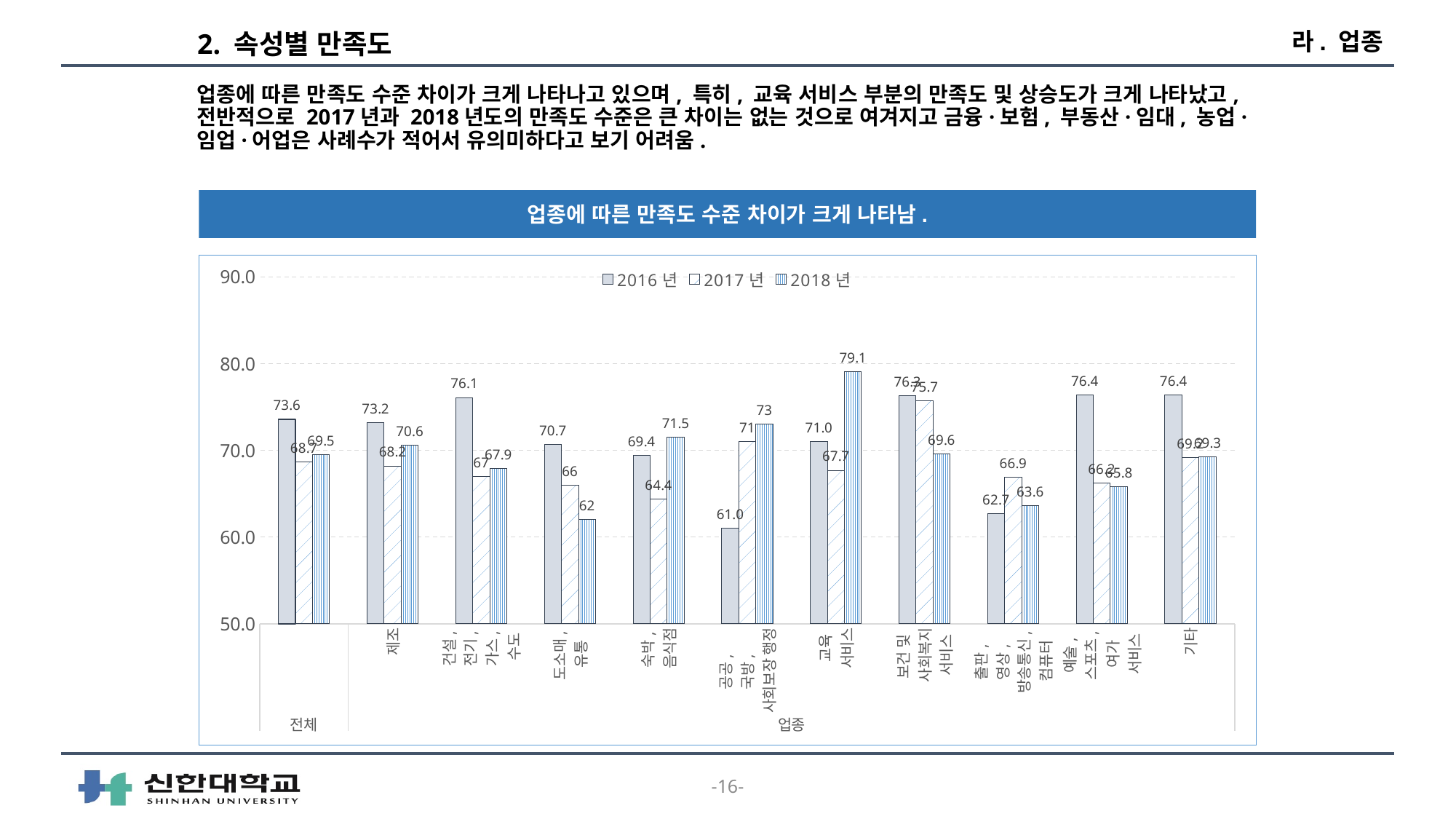
What kind of chart is shown on the slide? bar chart What is the 2017 년 value for 숙박, 음식점? 64.4 What is the difference between the 2018 년 and 2017 년 values for 교육 서비스? 11.4 What is the 2017 년 value for 보건 및 사회복지 서비스? 75.7 What is the 2018 년 value for 교육 서비스? 79.1 How many series does the legend list? 3 How many categories are shown along the x axis? 11 What are the three series listed in the legend? 2016 년, 2017 년, 2018 년 What is the 2016 년 value for 전체? 73.6 Do the values for 공공, 국방, 사회보장 행정 rise or fall from 2016 년 to 2018 년? rise Which category has the lowest 2016 년 value? 공공, 국방, 사회보장 행정 Which category has the highest 2018 년 value? 교육 서비스